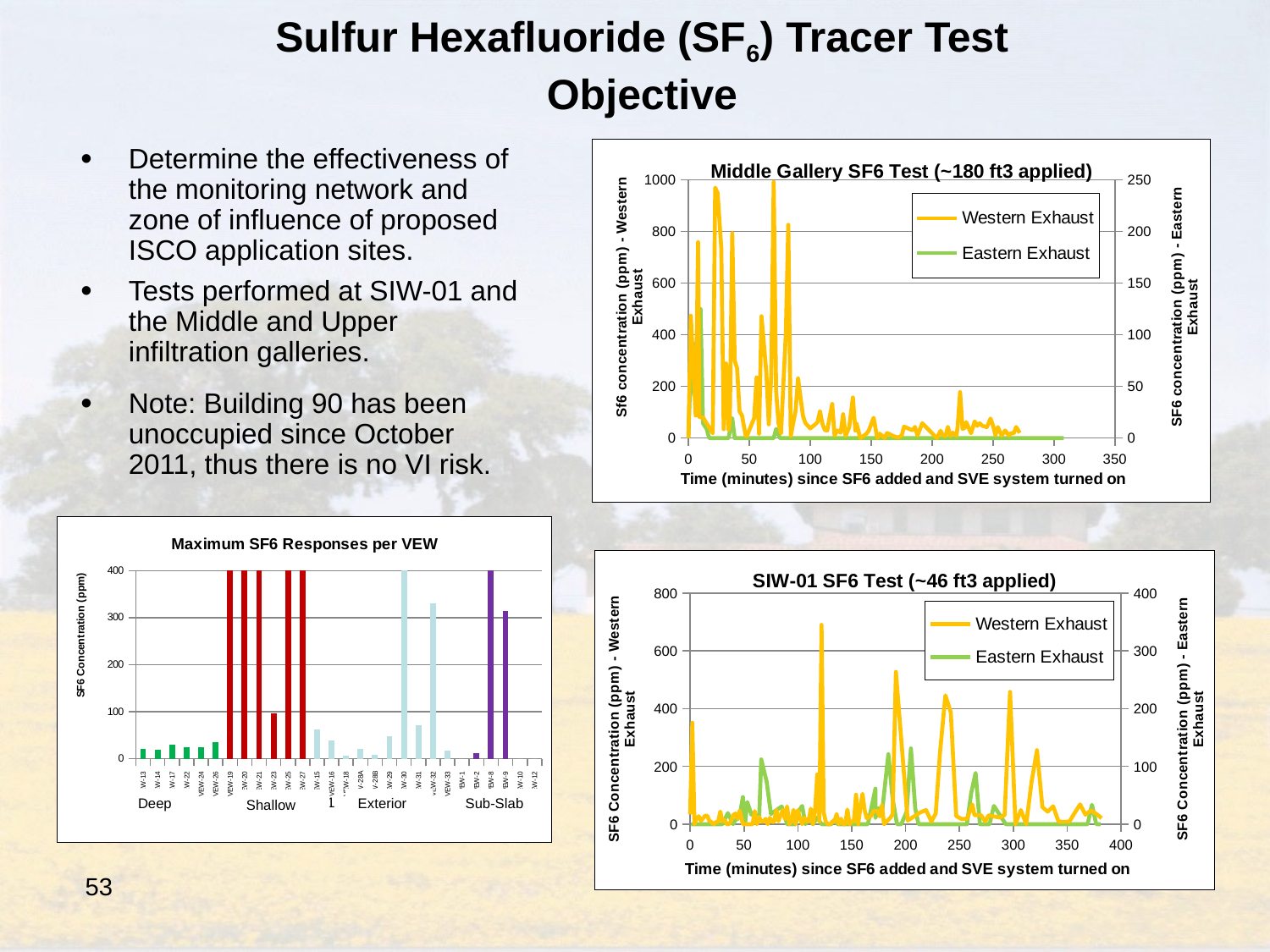
What is the x-axis label of the "SIW-01 SF6 Test (~46 ft3 applied)" chart? Time (minutes) since SF6 added and SVE system turned on How many series does the legend of the "Middle Gallery SF6 Test (~180 ft3 applied)" chart list? 2 In the "Middle Gallery SF6 Test (~180 ft3 applied)" chart, is the highest Western Exhaust value greater or less than 800? greater In the "Maximum SF6 Responses per VEW" chart, are the bars in the Deep group greater or less than 100? less How many series does the legend of the "SIW-01 SF6 Test (~46 ft3 applied)" chart list? 2 In the "SIW-01 SF6 Test (~46 ft3 applied)" chart, is the highest Western Exhaust value greater or less than 600? greater What kind of chart is the "Maximum SF6 Responses per VEW" chart? bar chart In the "Middle Gallery SF6 Test (~180 ft3 applied)" chart, does the Western Exhaust concentration generally rise or fall as time increases? fall In the "Middle Gallery SF6 Test (~180 ft3 applied)" chart, which series is drawn in green? Eastern Exhaust In the "Maximum SF6 Responses per VEW" chart, which group of wells is shown in red bars? Shallow What kind of chart is the "Middle Gallery SF6 Test (~180 ft3 applied)" chart? line chart